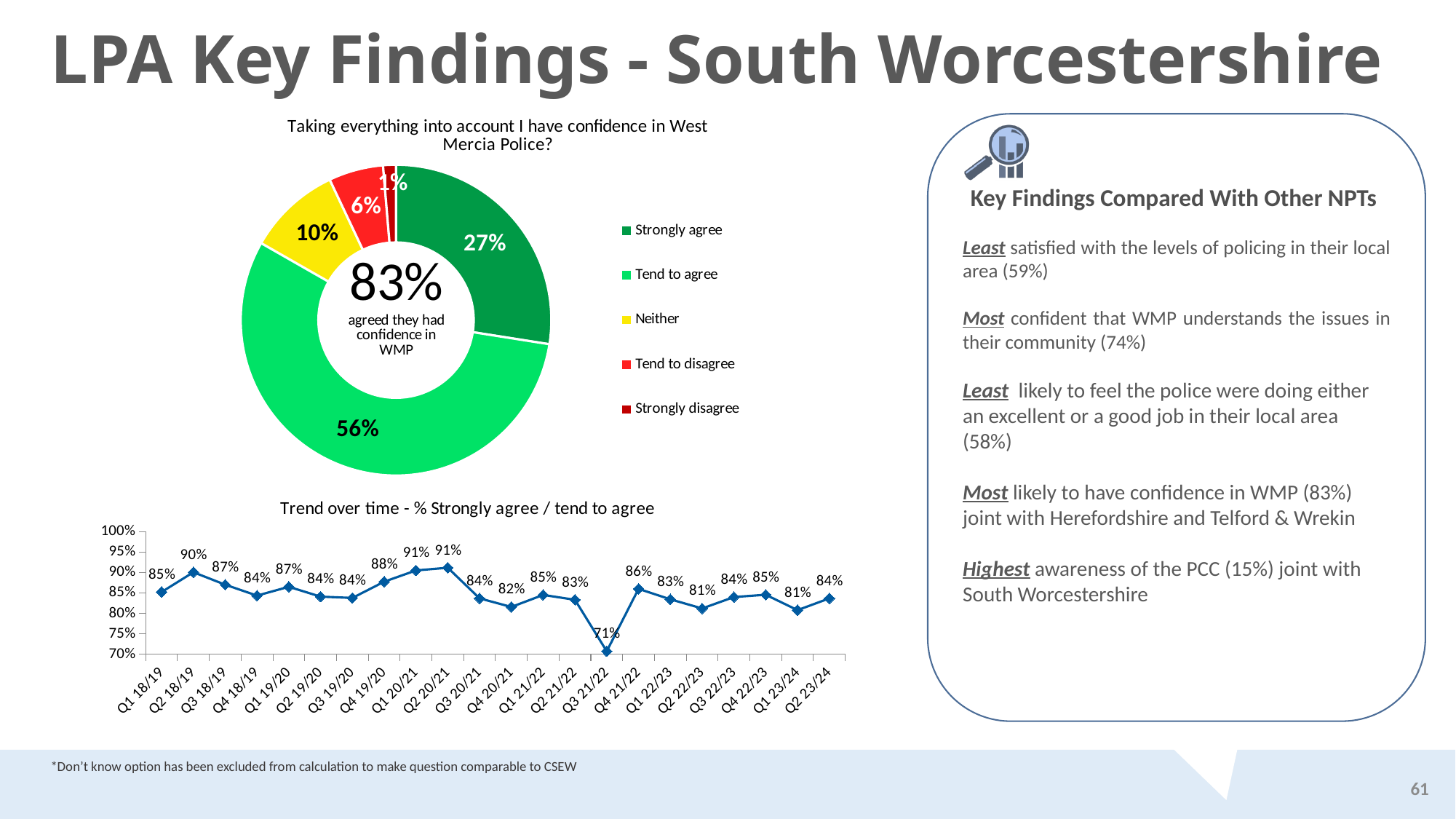
In the donut chart 'Taking everything into account I have confidence in West Mercia Police?', what percentage is shown for Strongly disagree? 1% In the chart 'Trend over time - % Strongly agree / tend to agree', which quarter has the lowest value? Q3 21/22 In the donut chart 'Taking everything into account I have confidence in West Mercia Police?', what colour is the Neither segment? Yellow In the chart 'Trend over time - % Strongly agree / tend to agree', what is the value for Q2 23/24? 84% In the chart 'Trend over time - % Strongly agree / tend to agree', which is larger, the value for Q2 18/19 or the value for Q4 20/21? Q2 18/19 In the chart 'Trend over time - % Strongly agree / tend to agree', what is the value for Q3 21/22? 71% How many data points are plotted in the chart 'Trend over time - % Strongly agree / tend to agree'? 22 In the donut chart 'Taking everything into account I have confidence in West Mercia Police?', what is the difference between the Neither and Tend to disagree percentages? 4% In the donut chart 'Taking everything into account I have confidence in West Mercia Police?', which category has the largest share? Tend to agree What kind of chart is 'Trend over time - % Strongly agree / tend to agree'? Line chart In the donut chart 'Taking everything into account I have confidence in West Mercia Police?', what percentage is shown for Tend to agree? 56% How many entries does the legend of the donut chart 'Taking everything into account I have confidence in West Mercia Police?' list? 5